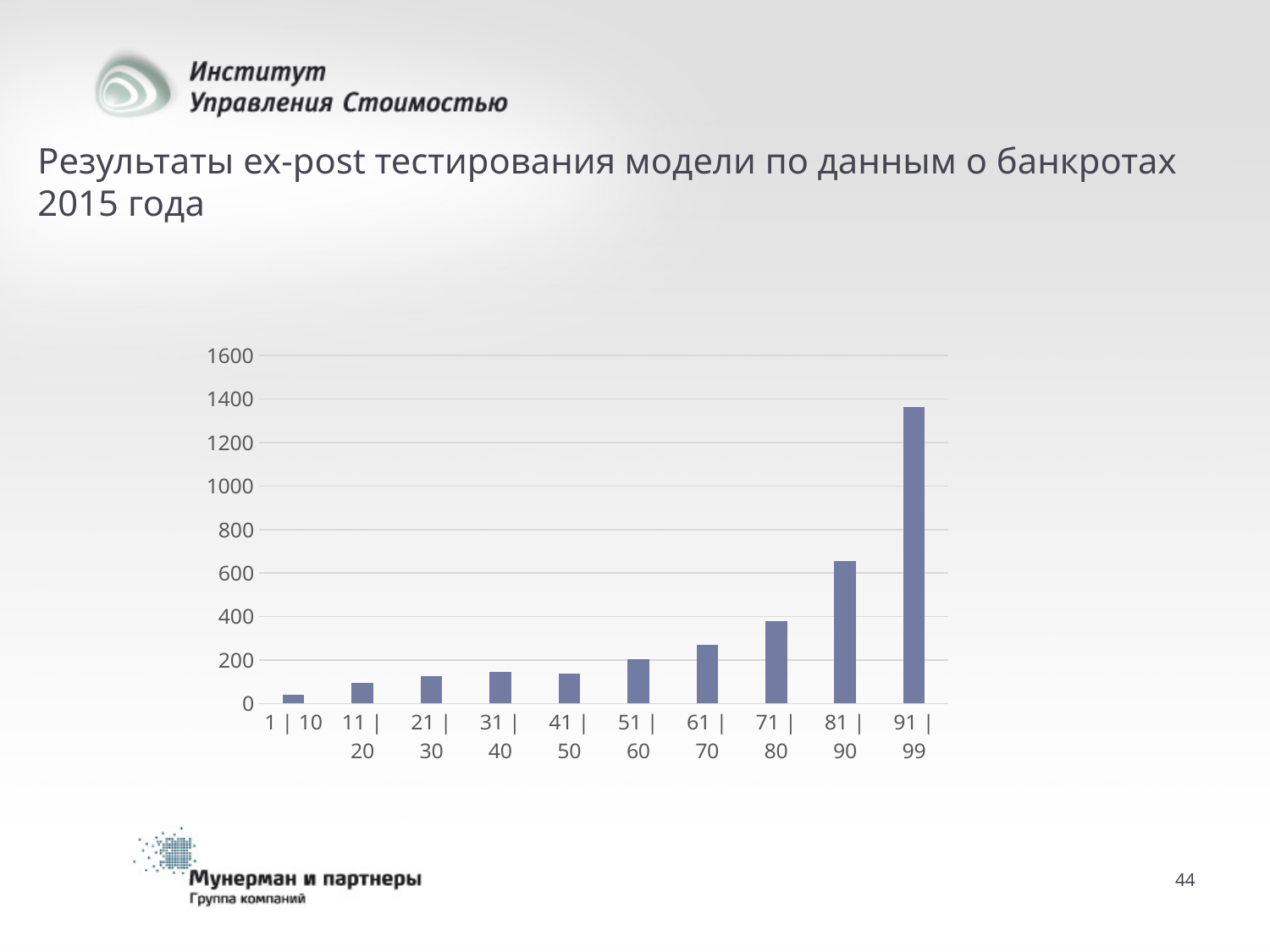
How many categories are shown on the x axis of the chart? 10 What kind of chart is shown on the slide? bar chart Is the value for 41 | 50 greater or less than 200? less Is the value for 81 | 90 greater or less than 600? greater What is the highest value shown on the vertical axis of the chart? 1600 Is the value for 91 | 99 greater or less than 1200? greater Do the values generally rise or fall moving from left to right along the x axis? rise Which category has the highest bar? 91 | 99 Which category has the lowest bar? 1 | 10 Which is larger, the value for 81 | 90 or the value for 71 | 80? 81 | 90